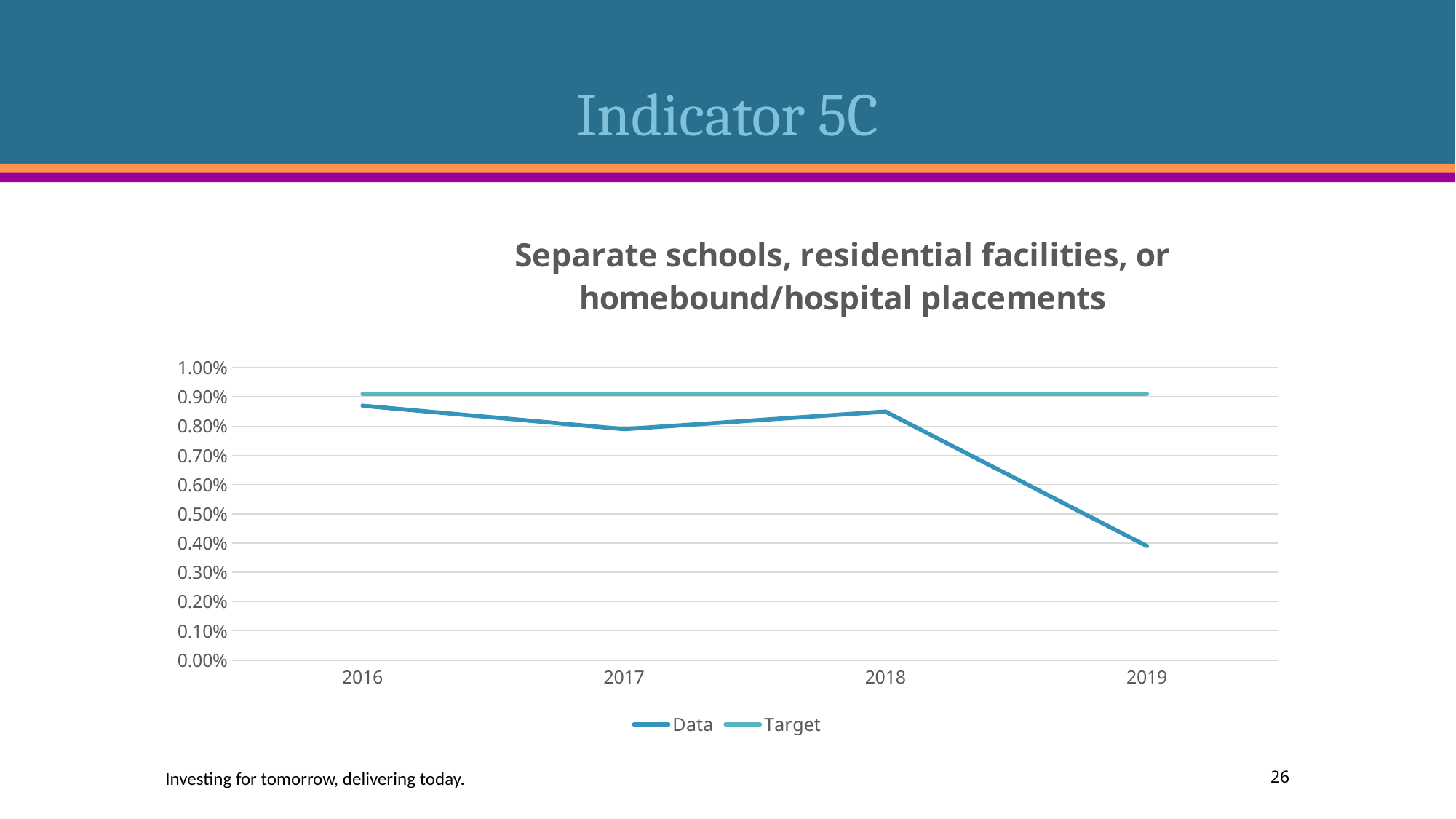
Is the Data value for 2017 greater or less than 0.70%? greater What are the two series named in the legend? Data and Target Is the Target value greater or less than 1.00%? less In 2019, which series has the higher value, Data or Target? Target Which is larger, the Data value for 2017 or the Data value for 2019? 2017 Does the Data series rise or fall from 2018 to 2019? fall How many years are shown on the x axis? 4 Is the Data value for 2019 greater or less than 0.50%? less What kind of chart is shown on the slide? line chart In which year is the Data series lowest? 2019 How many series does the legend list? 2